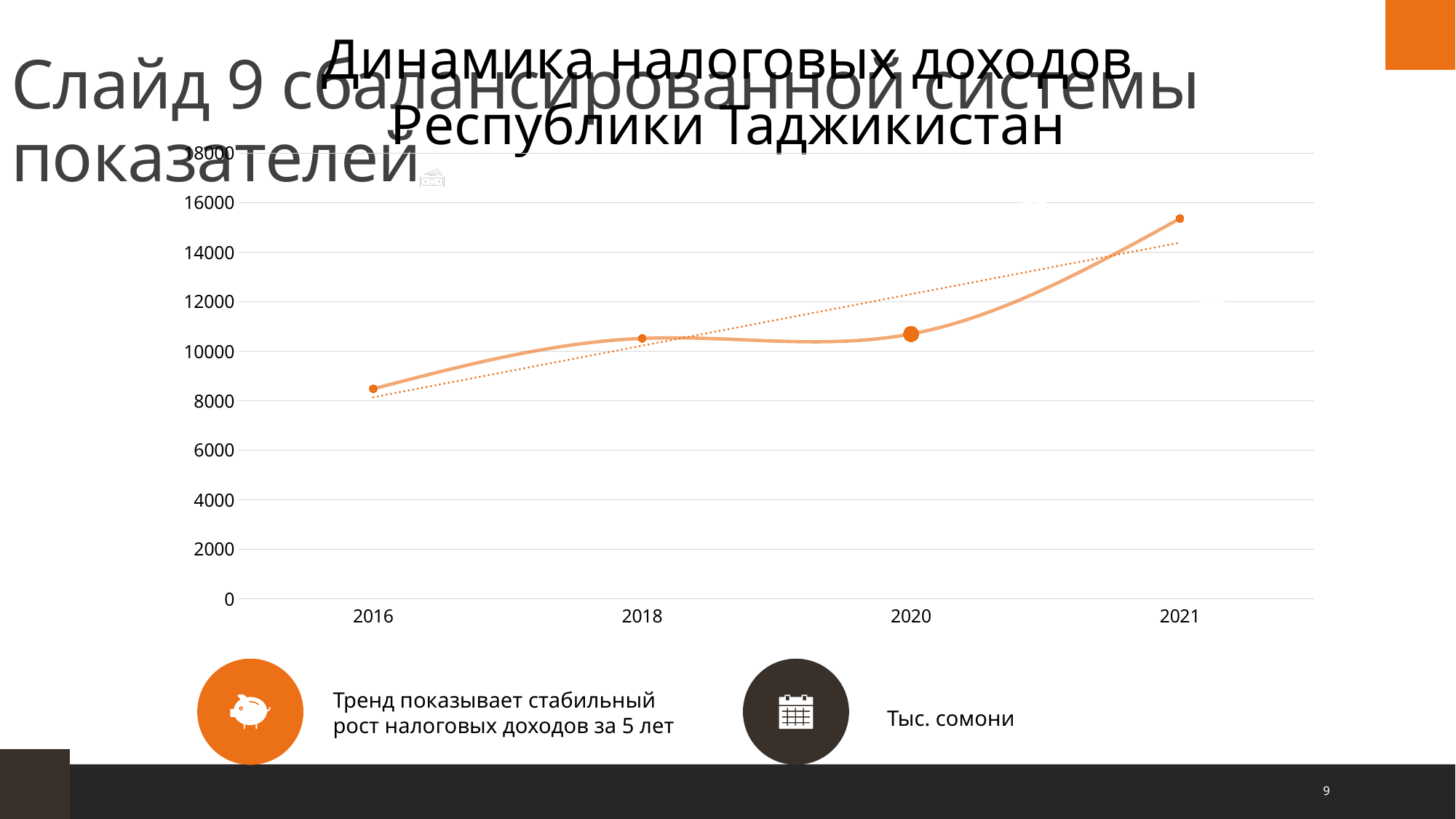
What is the title of the chart? Динамика налоговых доходов Республики Таджикистан Do the values in the chart generally rise or fall from 2016 to 2021? rise Is the value for 2018 greater or less than 10000? greater How many years are plotted on the x axis of the chart? 4 Is the value for 2021 greater or less than 16000? less Which year has the lowest tax revenue value in the chart? 2016 Which year has the highest tax revenue value in the chart? 2021 Which is larger, the value for 2021 or the value for 2016? 2021 In what unit are the chart values expressed, according to the slide? Тыс. сомони Is the value for 2021 greater or less than 14000? greater What kind of chart is shown on the slide? line chart